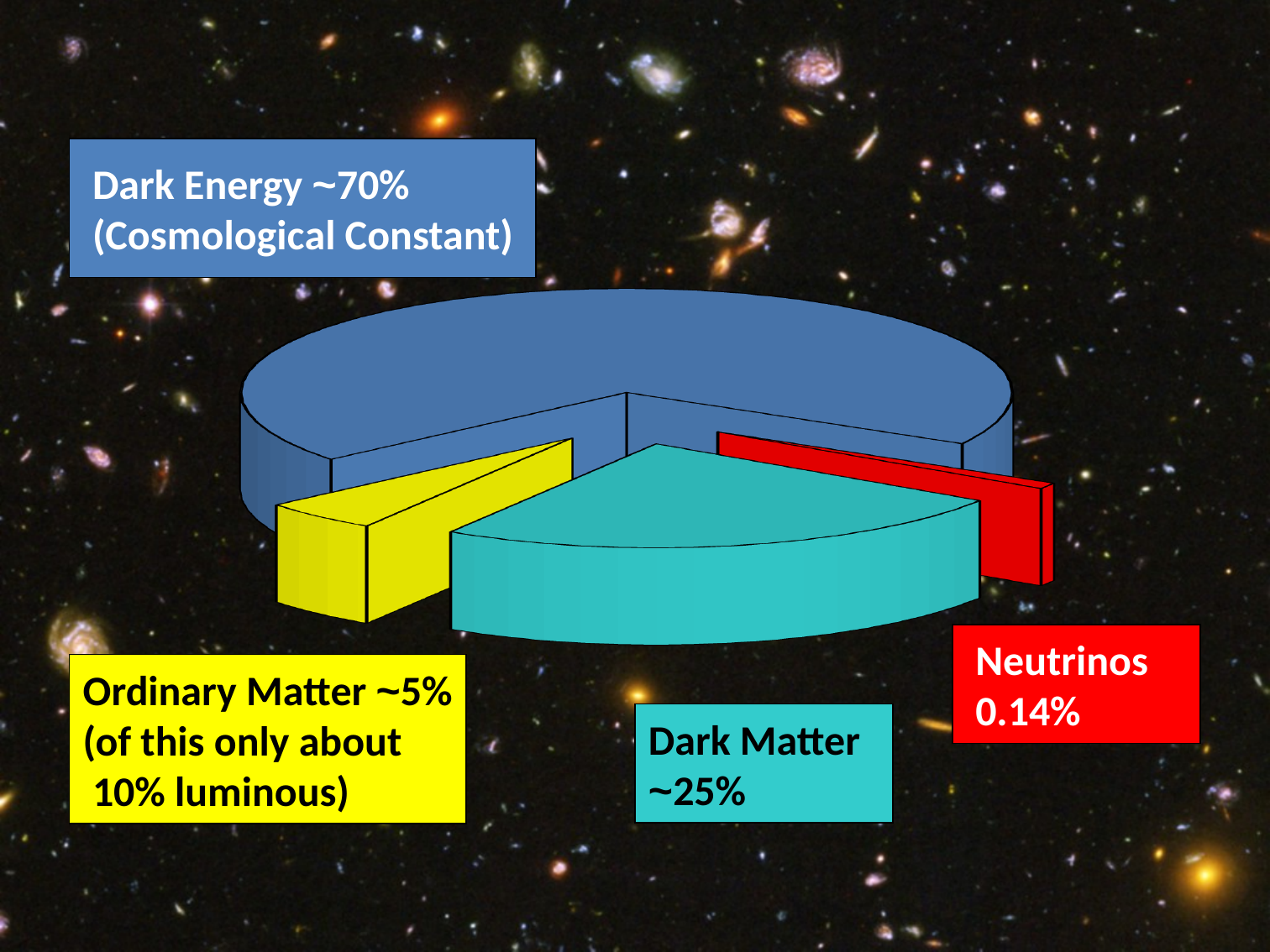
What percentage is shown for Dark Matter? ~25% How many slices does the pie chart have? 4 Which is larger, the Dark Matter slice or the Ordinary Matter slice? Dark Matter What percentage is shown for Dark Energy? ~70% Which component has the smallest slice of the pie chart? Neutrinos What kind of chart is shown on the slide? pie chart What colour is the Dark Matter slice? cyan What is written in parentheses under the Dark Energy label? Cosmological Constant What percentage is shown for Ordinary Matter? ~5% Which component has the largest slice of the pie chart? Dark Energy What percentage is shown for Neutrinos? 0.14% Which is larger, the Ordinary Matter slice or the Neutrinos slice? Ordinary Matter